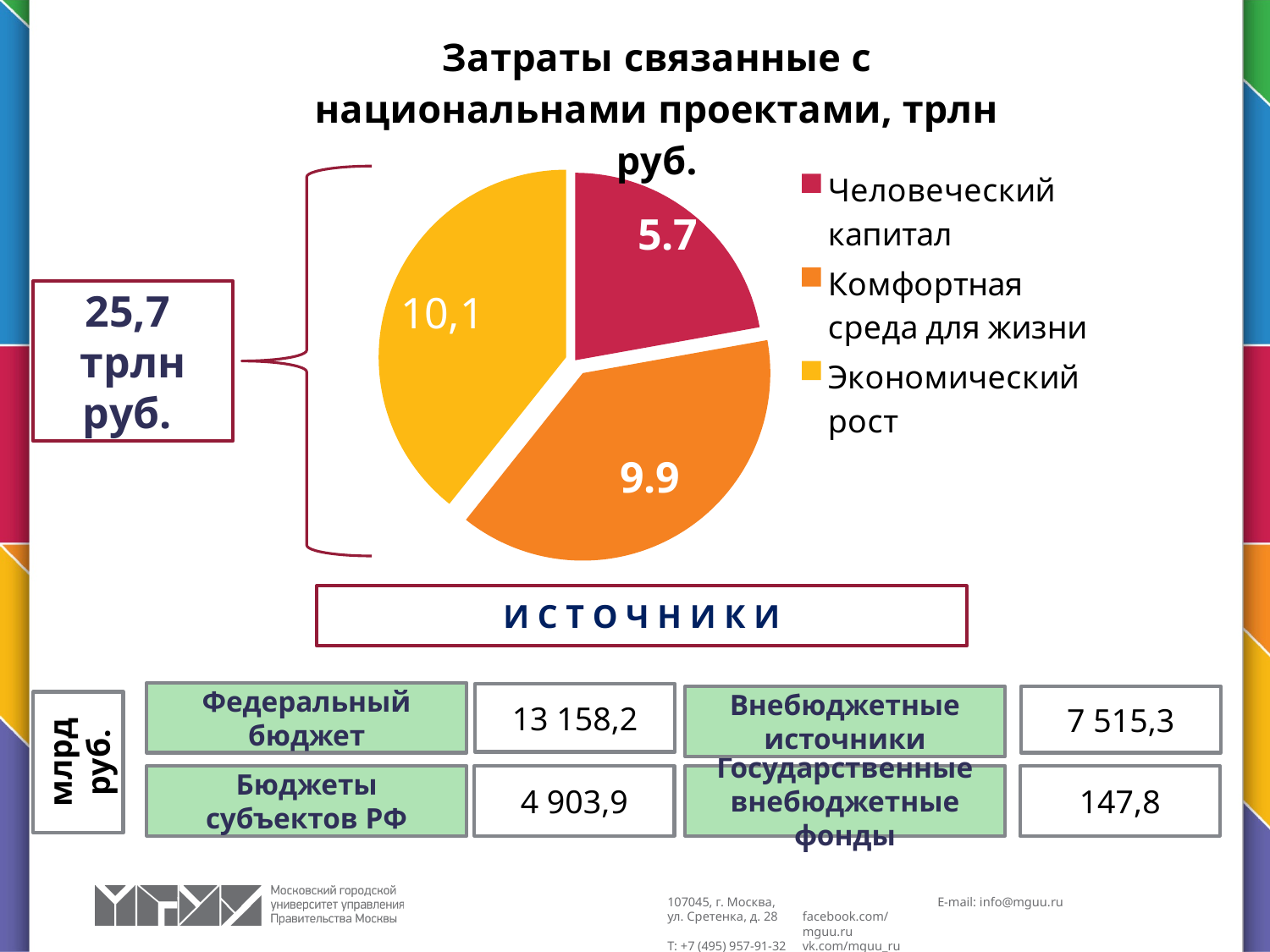
How many slices does the pie chart have? 3 What is the value for Экономический рост in the pie chart? 10,1 What is the value for Человеческий капитал in the pie chart? 5.7 What is the value for Комфортная среда для жизни in the pie chart? 9.9 What is the difference between the values for Комфортная среда для жизни and Человеческий капитал? 4.2 What kind of chart is shown on the slide? pie chart Which category has the largest slice in the pie chart? Экономический рост Which is larger: Комфортная среда для жизни or Человеческий капитал? Комфортная среда для жизни What is the difference between the values for Экономический рост and Человеческий капитал? 4,4 What is the total of all slices in the pie chart, as shown on the slide? 25,7 трлн руб. Which category has the smallest slice in the pie chart? Человеческий капитал How many entries does the legend of the pie chart list? 3